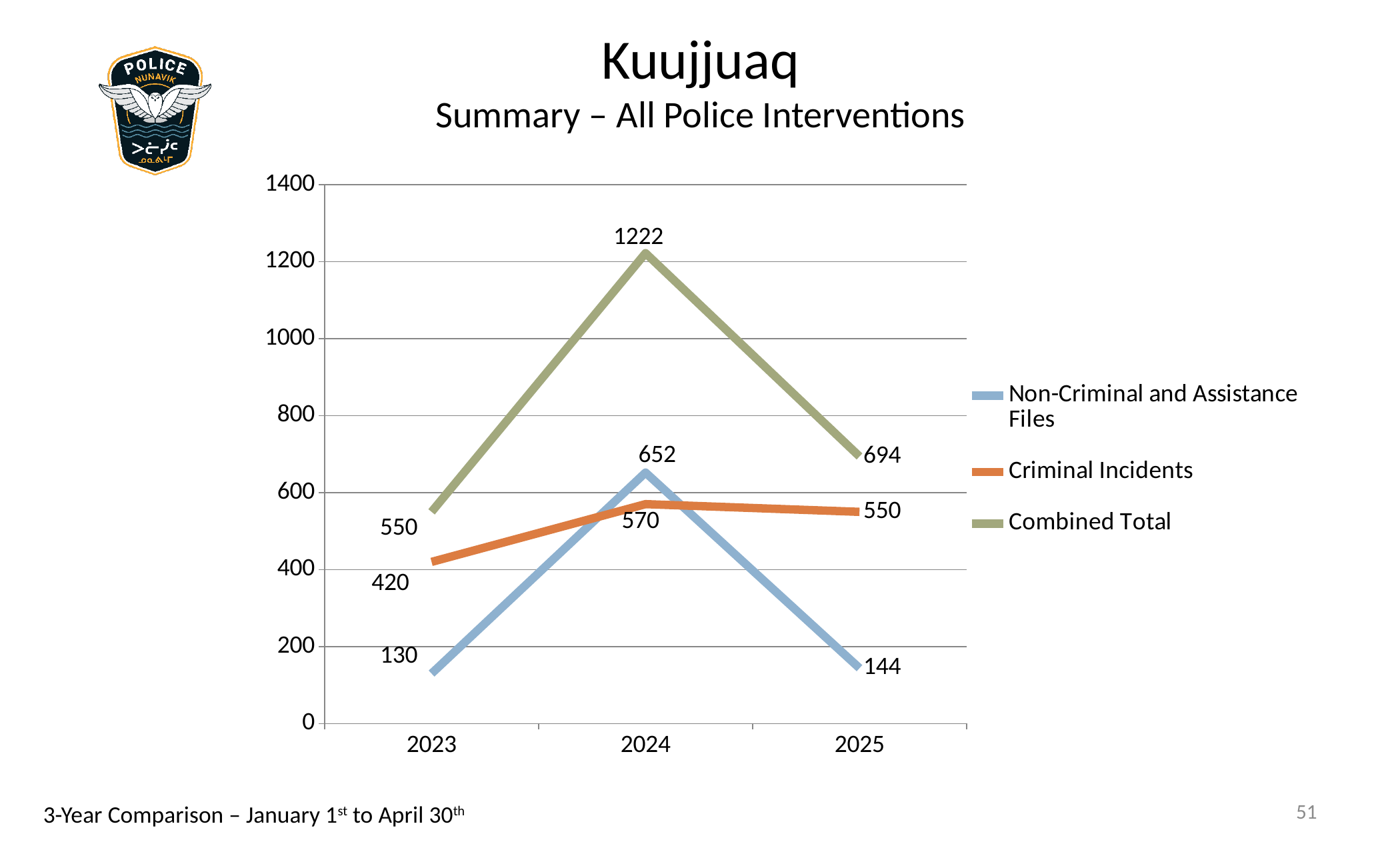
What kind of chart is shown on the slide? Line chart What colour is the Criminal Incidents line? Orange What is the value for Criminal Incidents in 2025? 550 How many series does the legend list? 3 What is the value for Non-Criminal and Assistance Files in 2023? 130 In which year is the Non-Criminal and Assistance Files value lowest? 2023 What is the difference between the Combined Total in 2024 and in 2025? 528 What is the Combined Total value for 2024? 1222 How many years are shown on the x axis? 3 Which is larger in 2024: Non-Criminal and Assistance Files or Criminal Incidents? Non-Criminal and Assistance Files Does the Non-Criminal and Assistance Files value rise or fall from 2024 to 2025? Fall In which year is the Combined Total highest? 2024